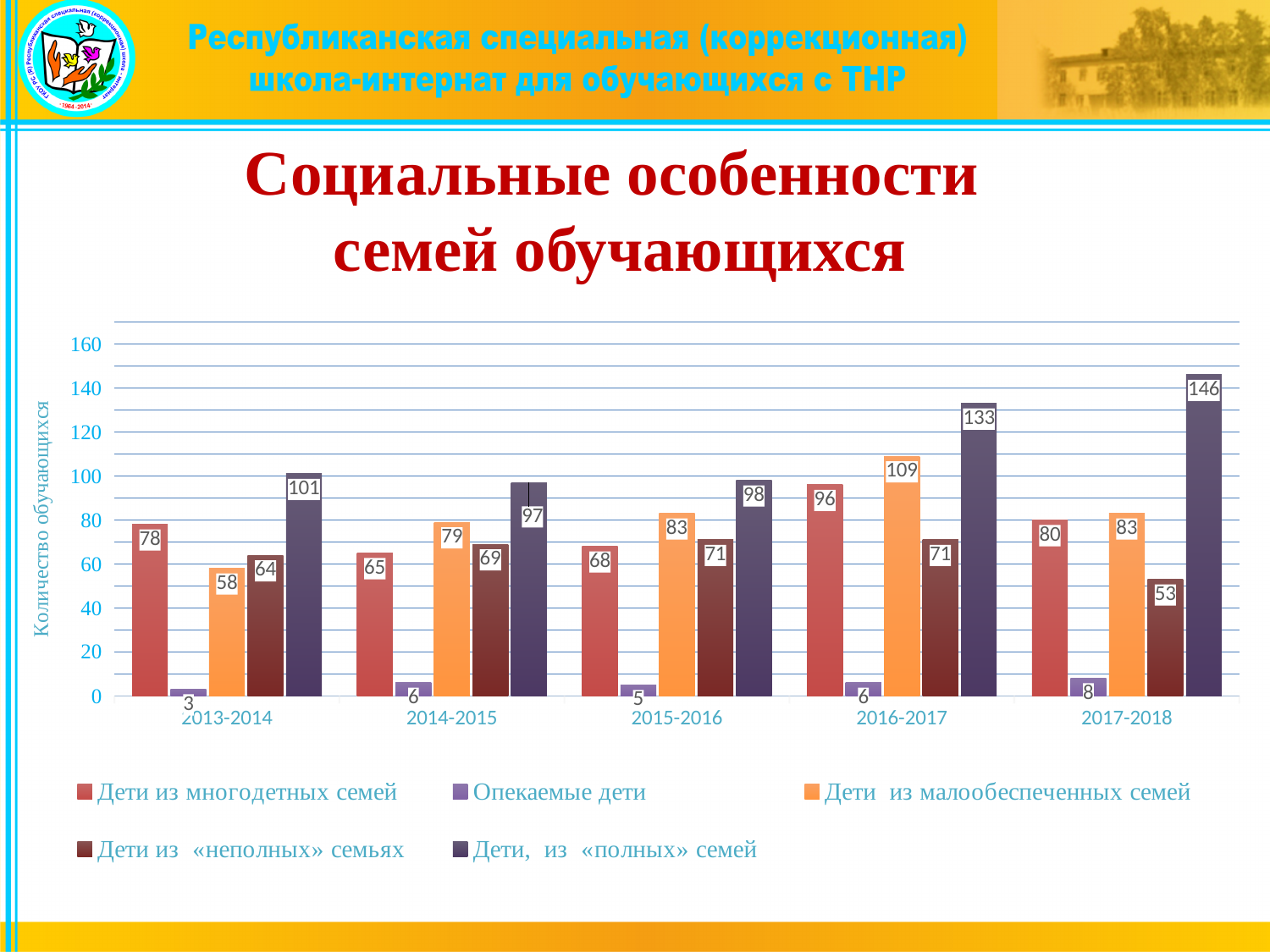
What is the label of the y axis? Количество обучающихся What type of chart is shown on the slide? bar chart What is the value for «Дети, из «полных» семей» in 2017-2018? 146 What is the value for «Опекаемые дети» in 2013-2014? 3 What is the value for «Дети из малообеспеченных семей» in 2016-2017? 109 In which school year is the value for «Дети из многодетных семей» the highest? 2016-2017 In which school year is the value for «Дети из «неполных» семьях» the lowest? 2017-2018 How many series does the legend list? 5 Which is larger in 2014-2015: «Дети из малообеспеченных семей» or «Дети из многодетных семей»? Дети из малообеспеченных семей What is the difference between the values for «Дети, из «полных» семей» in 2017-2018 and 2016-2017? 13 How many school-year categories are shown on the x axis? 5 Does the value for «Дети, из «полных» семей» rise or fall from 2015-2016 to 2017-2018? rise